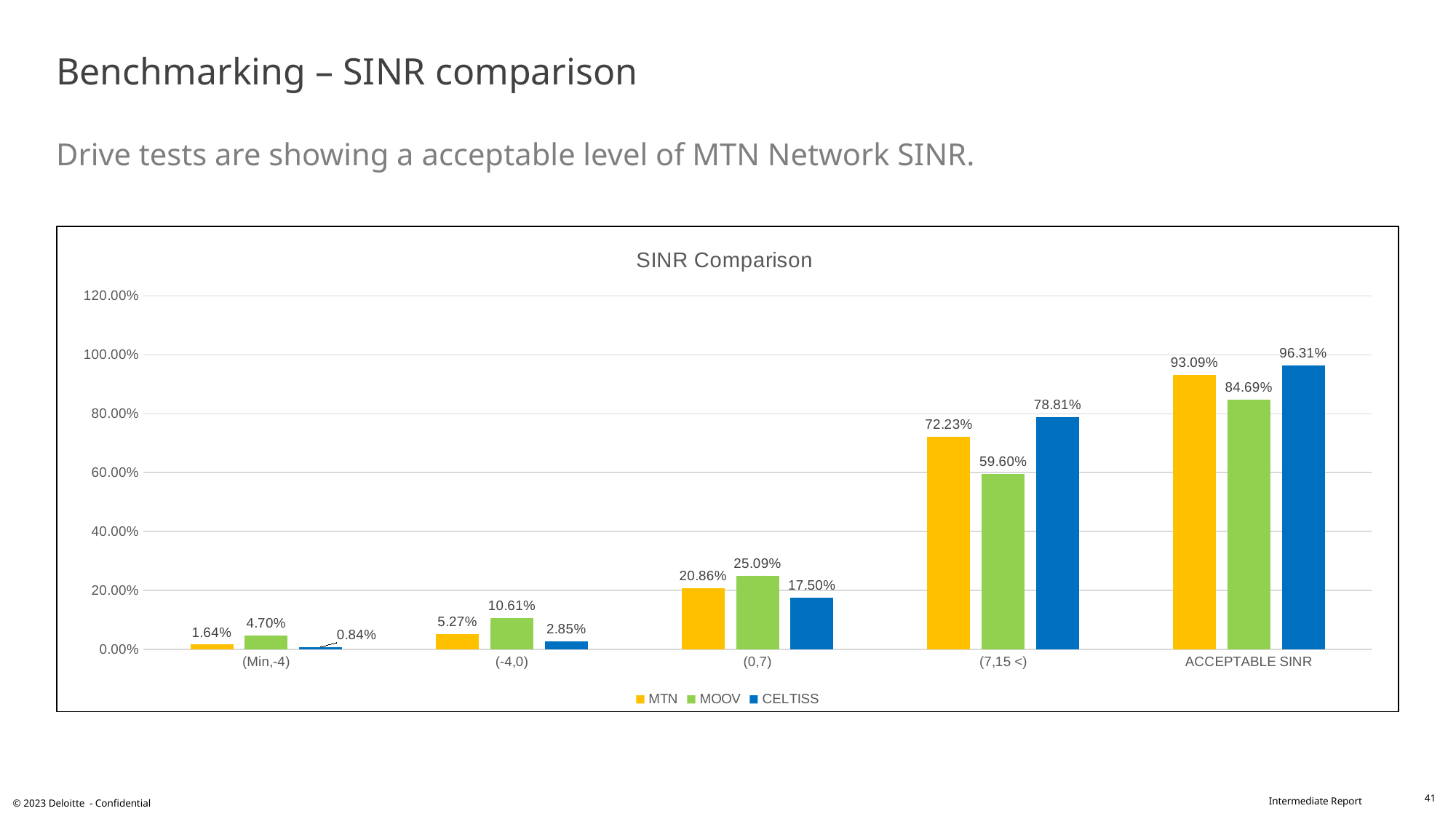
What is the difference between the MTN and MOOV values in the (7,15 <) category? 12.63% Which series has the highest value in the ACCEPTABLE SINR category? CELTISS In the (-4,0) category, which is larger: the MOOV value or the MTN value? MOOV Which series has the lowest value in the (Min,-4) category? CELTISS Is the MTN value for the (7,15 <) category greater or less than 60.00%? greater What is the MOOV value for the (0,7) category? 25.09% What is the MTN value for the ACCEPTABLE SINR category? 93.09% What is the title of the chart? SINR Comparison How many series does the legend list? 3 What is the CELTISS value for the (7,15 <) category? 78.81% How many categories are shown on the x axis? 5 What kind of chart is shown on the slide? Bar chart